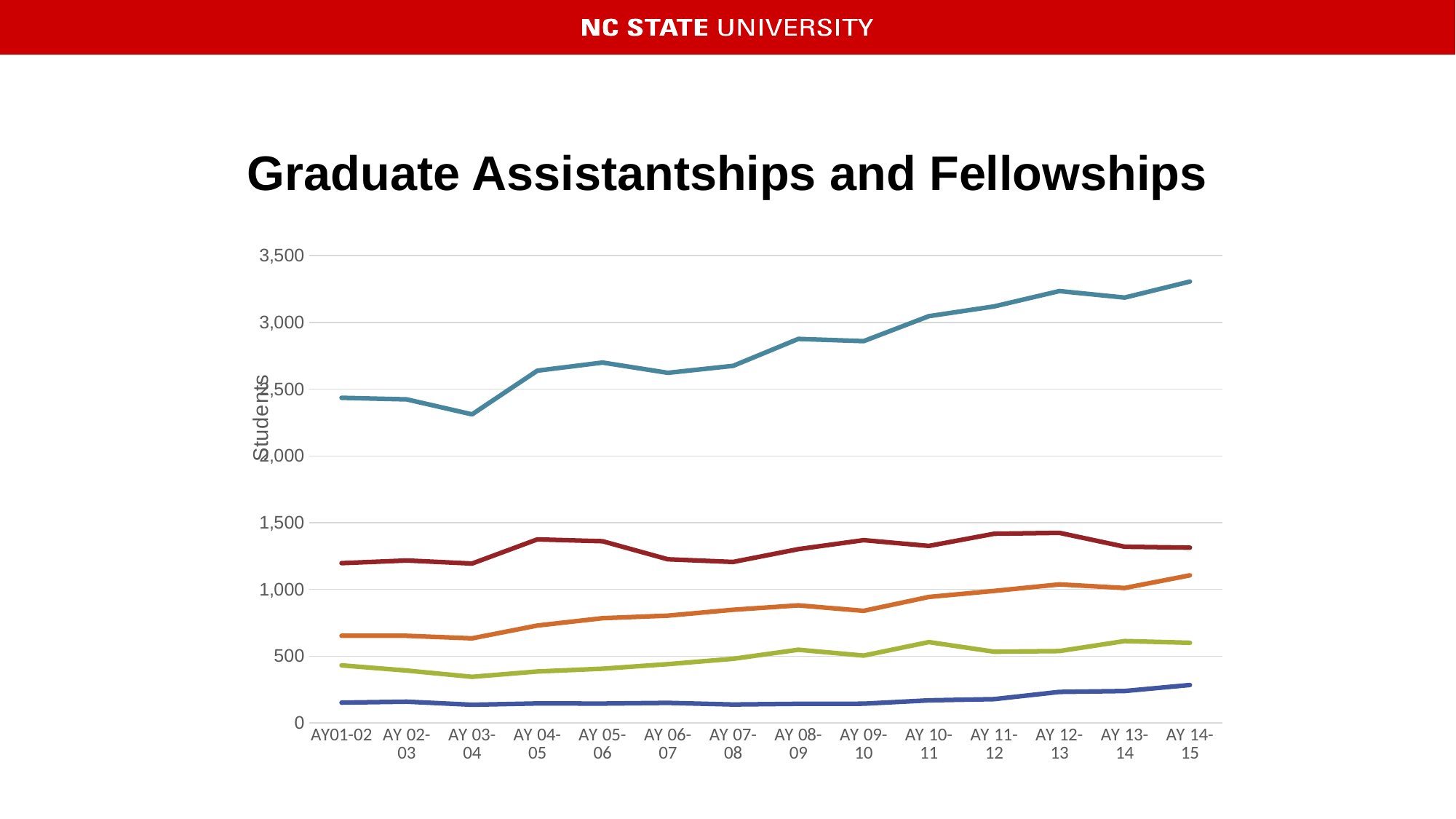
Is the value of the orange line at AY 14-15 greater or less than 1,000? greater How many academic years are shown along the x axis? 14 Does the teal line generally rise or fall from AY01-02 to AY 14-15? rise Which line is the highest across all academic years? the teal line What is the title of the chart? Graduate Assistantships and Fellowships Is the value of the teal line at AY 03-04 greater or less than 2,500? less What kind of chart is shown on the slide? line chart Is the value of the teal line at AY 14-15 greater or less than 3,000? greater What is the label on the vertical axis of the chart? Students How many lines are plotted on the chart? 5 Which line is the lowest across all academic years? the dark blue line